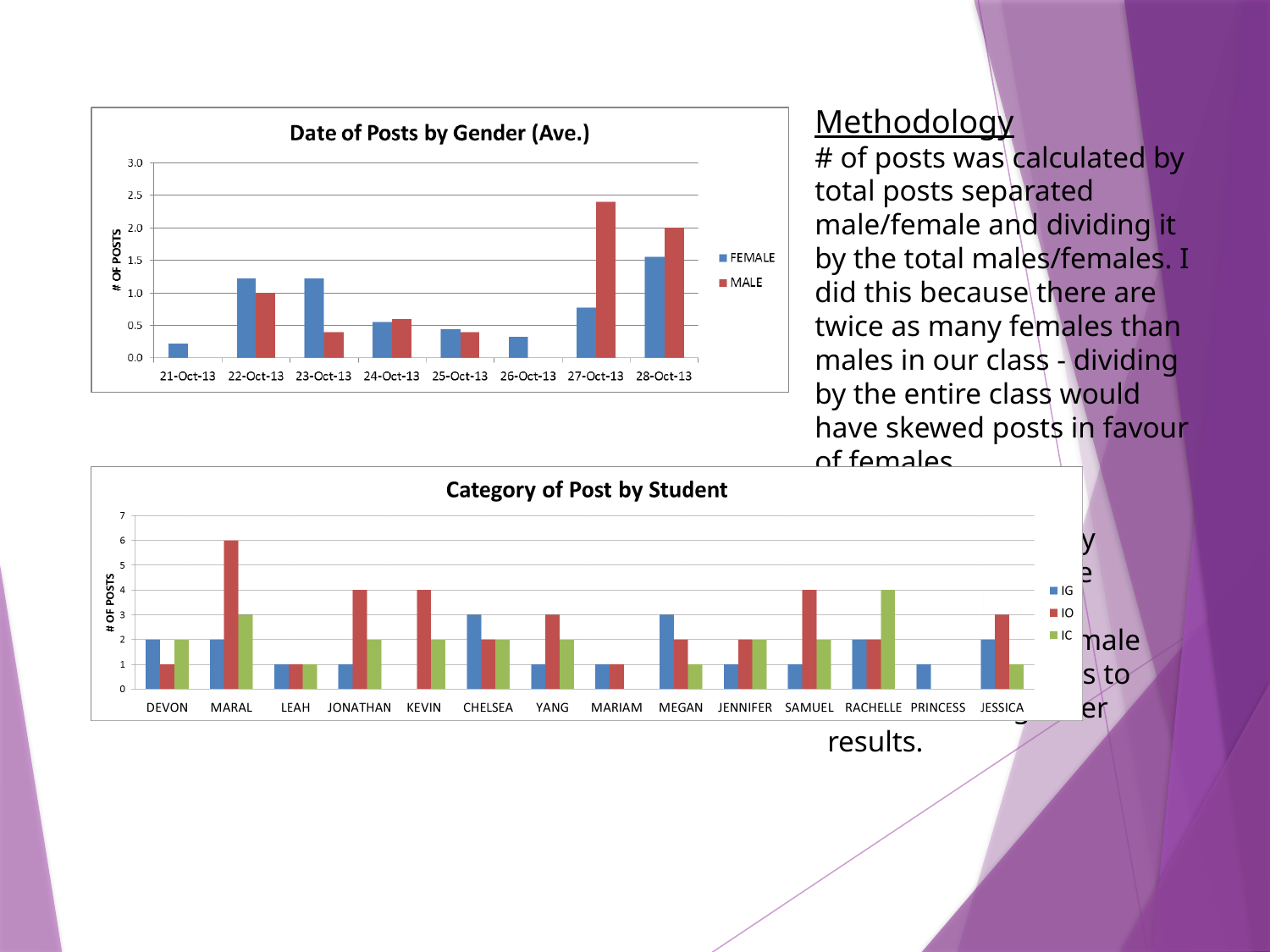
In the 'Category of Post by Student' chart, what is the IO value for MARAL? 6 In the 'Category of Post by Student' chart, what is the difference between the IO value for KEVIN and the IO value for LEAH? 3 In the 'Category of Post by Student' chart, which student has the highest IO value? MARAL In the 'Date of Posts by Gender (Ave.)' chart, is the FEMALE value for 21-Oct-13 greater or less than 0.5? less In the 'Date of Posts by Gender (Ave.)' chart, is the MALE value for 27-Oct-13 greater or less than 2.0? greater In the 'Date of Posts by Gender (Ave.)' chart, which is larger on 23-Oct-13, the FEMALE value or the MALE value? FEMALE In the 'Date of Posts by Gender (Ave.)' chart, on which date is the MALE value highest? 27-Oct-13 In the 'Category of Post by Student' chart, what is the IC value for RACHELLE? 4 In the 'Category of Post by Student' chart, how many students are shown on the x axis? 14 In the 'Date of Posts by Gender (Ave.)' chart, how many dates are shown on the x axis? 8 What type of chart is 'Category of Post by Student'? Bar chart In the 'Date of Posts by Gender (Ave.)' chart, how many series does the legend list? 2